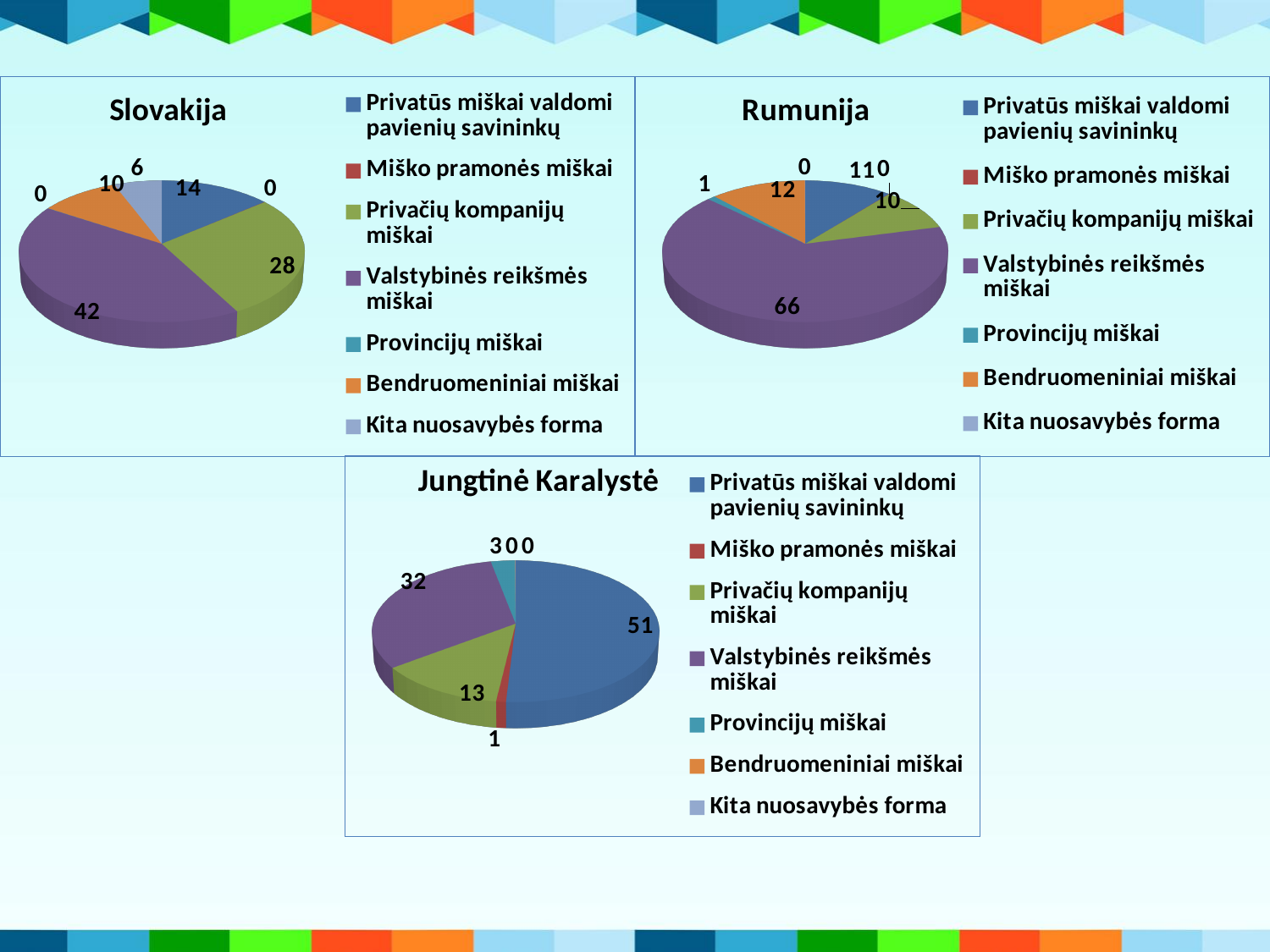
In the Rumunija chart, which is larger, Bendruomeniniai miškai or Privačių kompanijų miškai? Bendruomeniniai miškai In the Rumunija chart, what is the value for Bendruomeniniai miškai? 12 In the Slovakija chart, what is the difference between Valstybinės reikšmės miškai and Privačių kompanijų miškai? 14 In the Rumunija chart, what is the value for Valstybinės reikšmės miškai? 66 In the Jungtinė Karalystė chart, what is the difference between Privatūs miškai valdomi pavienių savininkų and Privačių kompanijų miškai? 38 In the Slovakija chart, what is the value for Valstybinės reikšmės miškai? 42 In the Jungtinė Karalystė chart, what is the value for Privatūs miškai valdomi pavienių savininkų? 51 In the Jungtinė Karalystė chart, what is the value for Valstybinės reikšmės miškai? 32 What kind of chart is the Jungtinė Karalystė chart? Pie chart In the Slovakija chart, which category has the largest slice? Valstybinės reikšmės miškai How many entries does the legend of the Slovakija chart list? 7 In the Slovakija chart, what is the value for Privačių kompanijų miškai? 28